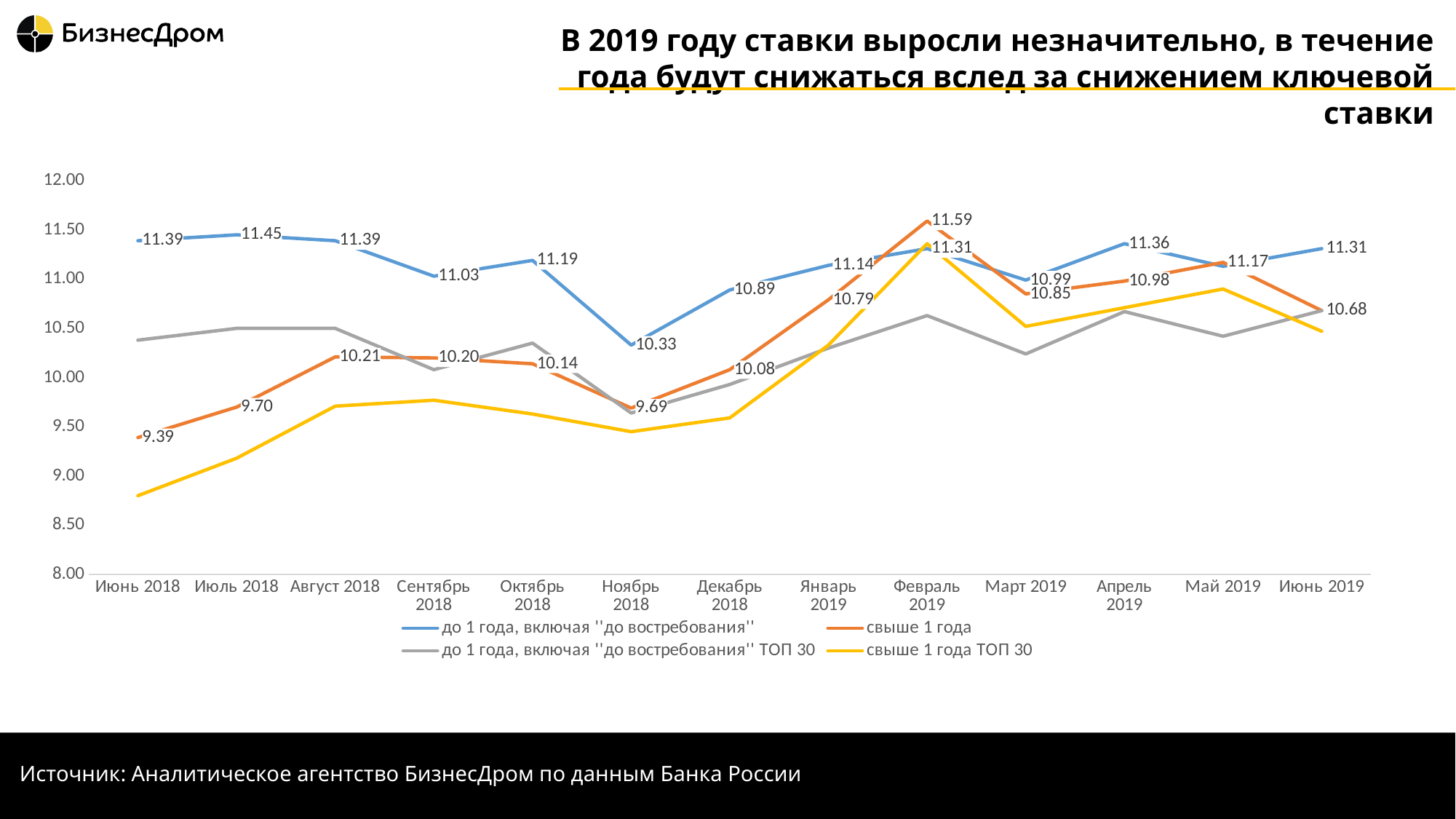
In Февраль 2019, which is larger: the 'свыше 1 года' series or the 'до 1 года, включая ''до востребования''' series? свыше 1 года Does the 'свыше 1 года' series rise or fall from Июнь 2018 to Август 2018? rise What is the value of the series 'до 1 года, включая ''до востребования''' in Июнь 2018? 11.39 In which month does the series 'до 1 года, включая ''до востребования''' reach its lowest value? Ноябрь 2018 In which month does the series 'свыше 1 года' reach its highest value? Февраль 2019 What is the difference between the 'до 1 года, включая ''до востребования''' series and the 'свыше 1 года' series in Июнь 2018? 2.00 Is the value of the 'свыше 1 года ТОП 30' series in Июнь 2018 greater or less than 9.00? less What is the value of the series 'свыше 1 года' in Июнь 2018? 9.39 What is the value of the series 'свыше 1 года' in Январь 2019? 10.79 What kind of chart is shown on the slide? line chart How many series does the legend list? 4 How many months are plotted along the x axis? 13